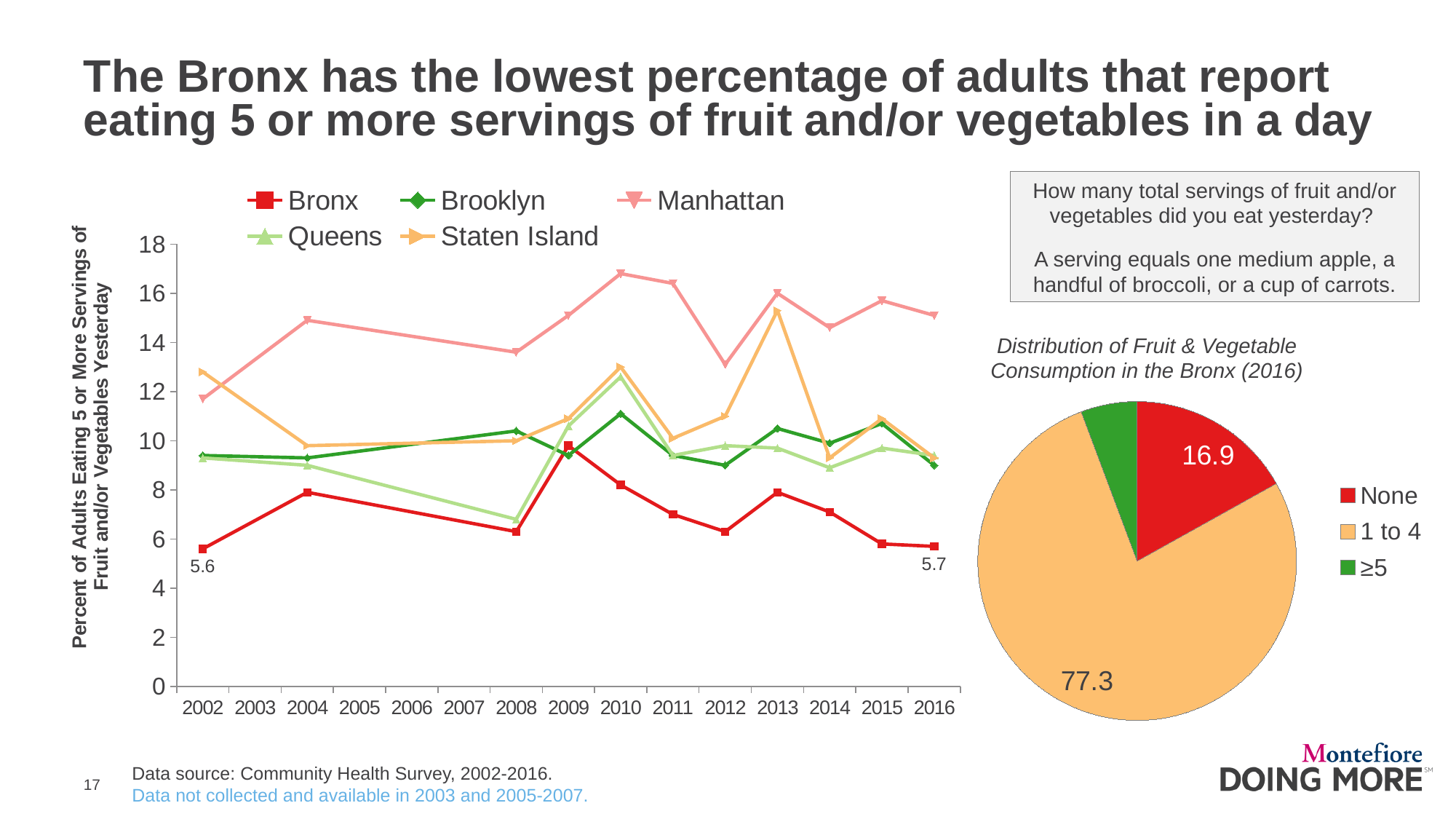
In the line chart, is the value for the Bronx in 2012 greater or less than 8? less In the line chart, which borough has the lowest value in 2016? Bronx In the line chart, what is the value for the Bronx in 2002? 5.6 In the pie chart 'Distribution of Fruit & Vegetable Consumption in the Bronx (2016)', what is the share for '1 to 4'? 77.3 In the line chart, which borough has the highest value in 2016? Manhattan In the line chart, does the Bronx line rise or fall from 2013 to 2016? fall In the line chart, what is the value for the Bronx in 2016? 5.7 In the line chart, how many series does the legend list? 5 In the pie chart 'Distribution of Fruit & Vegetable Consumption in the Bronx (2016)', what is the value for 'None'? 16.9 In the line chart, is the value for Manhattan in 2010 greater or less than 16? greater What kind of chart is the chart on the left of the slide? line chart In the pie chart 'Distribution of Fruit & Vegetable Consumption in the Bronx (2016)', what is the difference between the '1 to 4' slice and the 'None' slice? 60.4